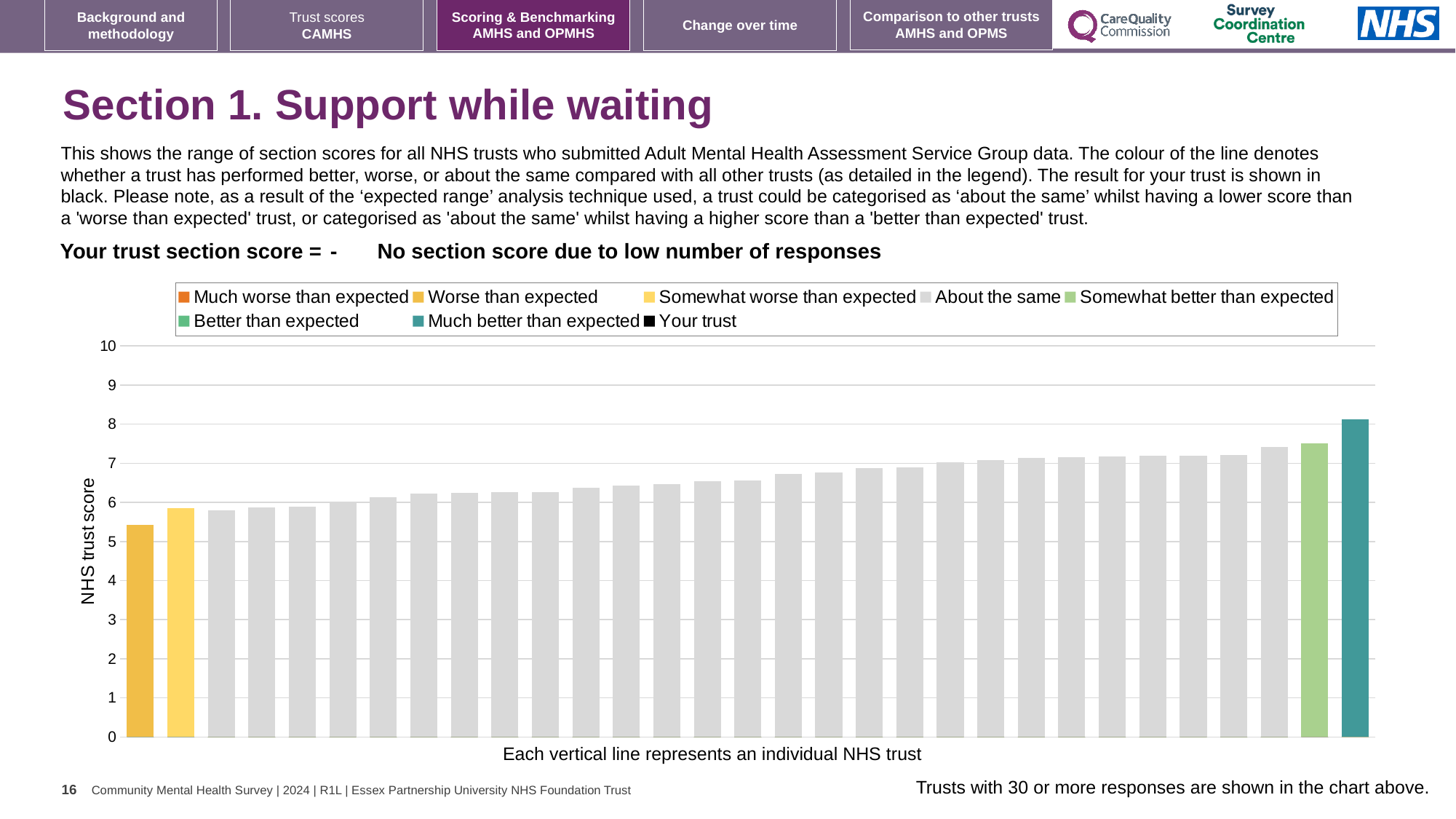
What is the label on the vertical axis of the chart? NHS trust score How many bars (NHS trusts) are plotted in the chart? 31 How many entries does the chart legend list? 8 Do the bar values rise or fall from left to right along the x axis? Rise What kind of chart is shown on the slide? Bar chart Is the rightmost bar taller or shorter than the leftmost bar? Taller What is the highest value shown on the vertical axis? 10 Which legend category does the tallest bar belong to? Much better than expected Which legend category does the shortest bar belong to? Worse than expected Is the value of the leftmost bar greater or less than 6? less Is the value of the leftmost bar greater or less than 5? greater Is the value of the rightmost bar greater or less than 7? greater